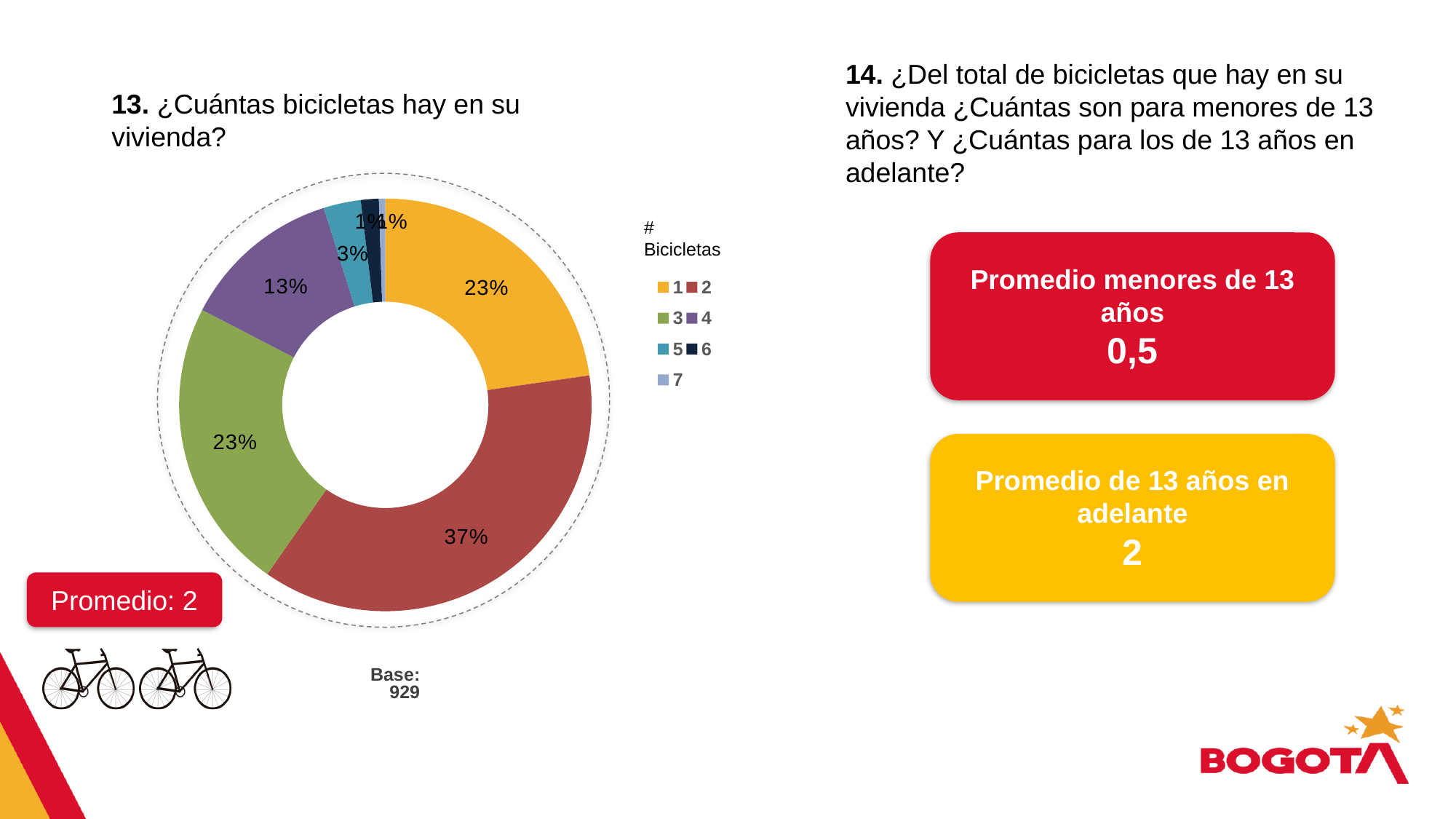
Which number of bicycles has the largest share of the pie? 2 What is the base (number of respondents) shown under the pie chart? 929 What percentage of households have 1 bicycle? 23% How many categories does the legend of the pie chart list? 7 What percentage of households have 4 bicycles? 13% What percentage of households have 2 bicycles? 37% What is the combined share of households with 1 bicycle and households with 3 bicycles? 46% Which has a larger share: 4 bicycles or 5 bicycles? 4 How many percentage points larger is the share for 2 bicycles than the share for 4 bicycles? 24 What kind of chart is used for question 13 (¿Cuántas bicicletas hay en su vivienda?)? doughnut chart What is the average (Promedio) number of bicycles shown next to the pie chart? 2 What percentage of households have 5 bicycles? 3%